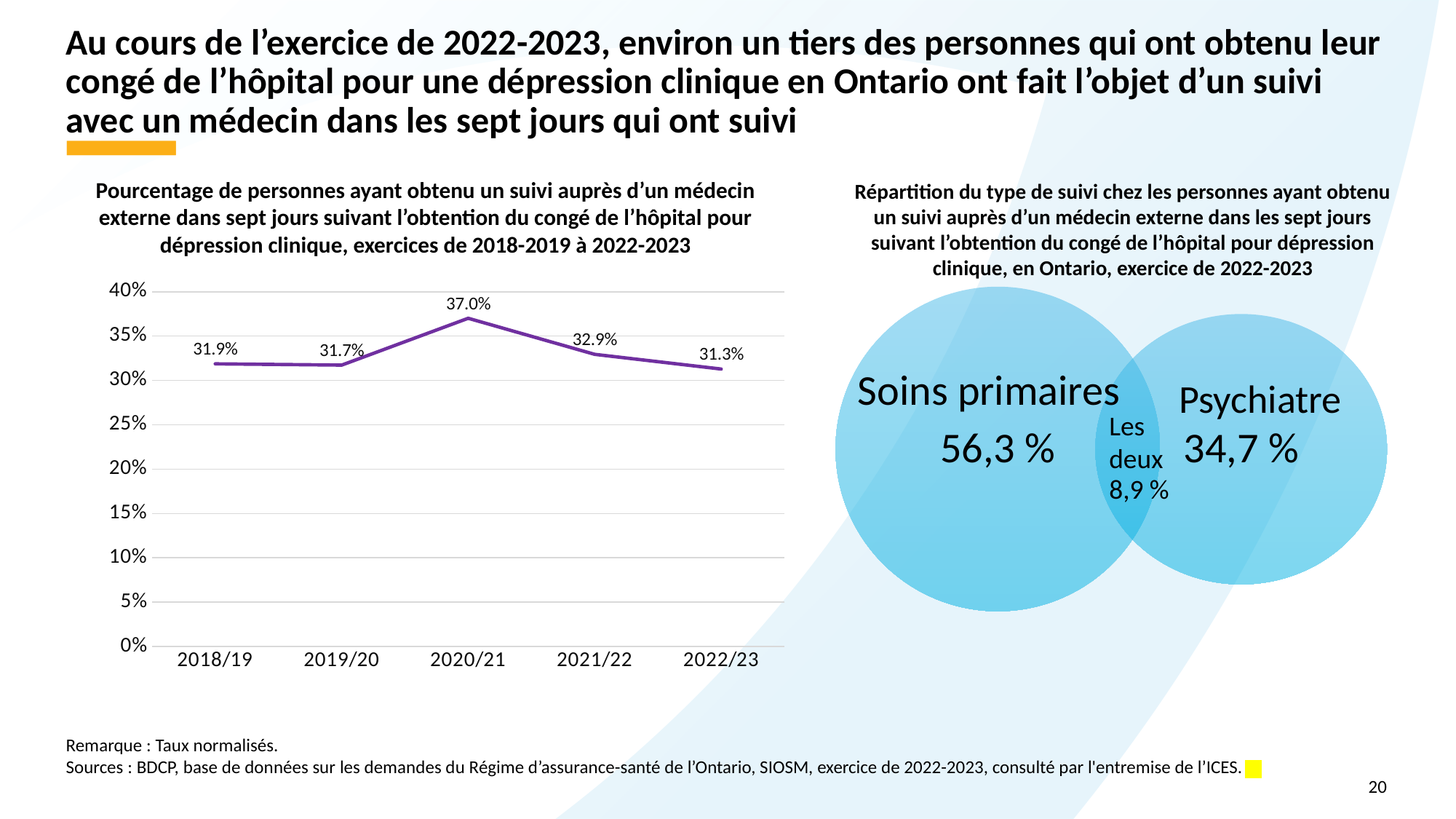
In the line chart on the left, what is the value for 2020/21? 37.0% In the line chart on the left, which is larger, the value for 2019/20 or the value for 2021/22? 2021/22 In the line chart on the left, does the value rise or fall from 2020/21 to 2022/23? Fall In the line chart on the left, which fiscal year has the highest value? 2020/21 What kind of chart is shown on the left of the slide? Line chart In the line chart on the left, what is the difference between the values for 2020/21 and 2021/22? 4.1 percentage points In the line chart on the left, what is the value for 2022/23? 31.3% In the Venn diagram on the right, what is the value shown for the overlap labelled Les deux? 8,9 % In the line chart on the left, which fiscal year has the lowest value? 2022/23 In the Venn diagram on the right, what is the value shown for Soins primaires? 56,3 % In the line chart on the left, what is the value for 2018/19? 31.9% In the line chart on the left, how many fiscal years are plotted on the x axis? 5